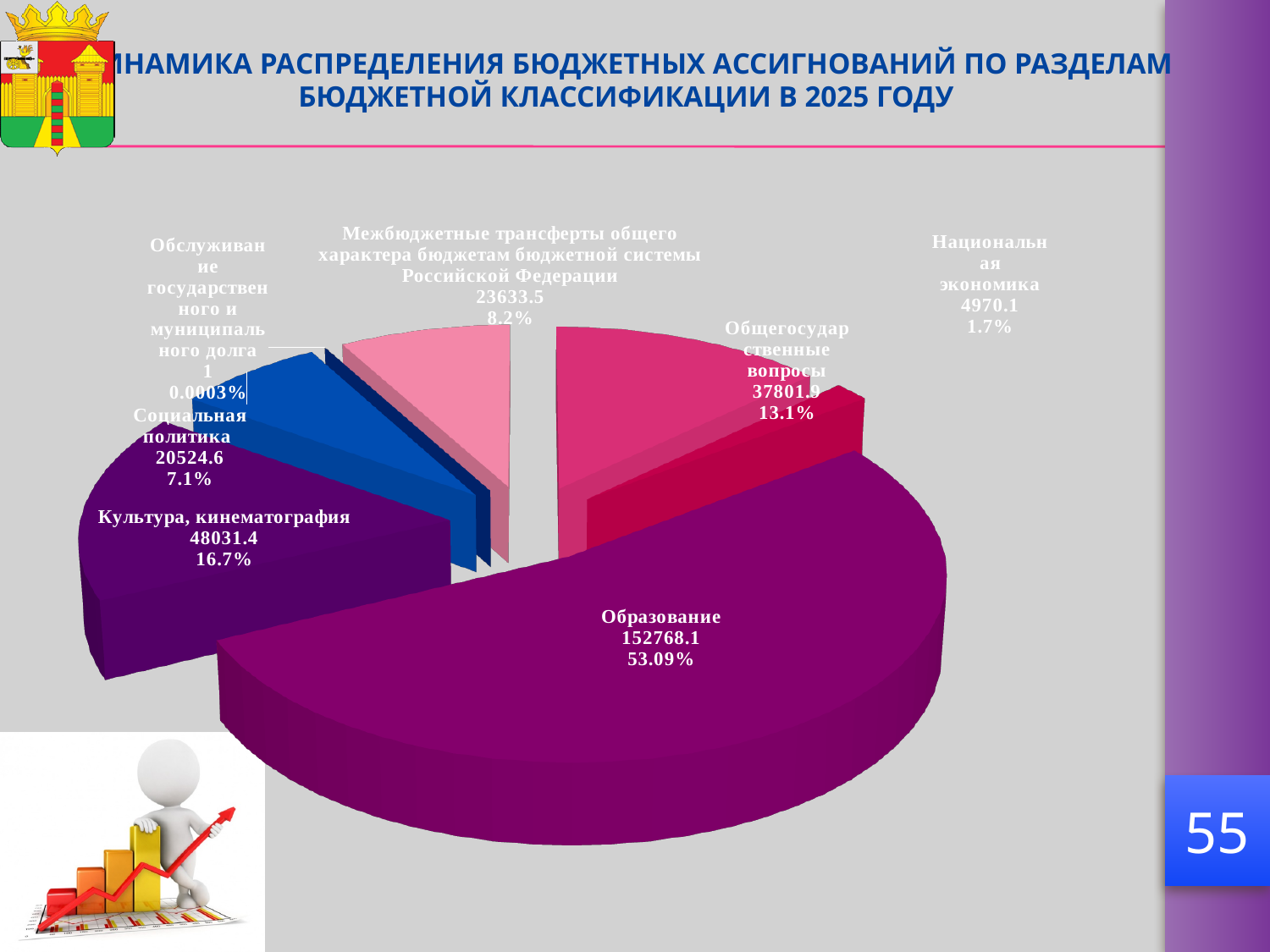
Which section has the largest slice of the pie? Образование What is the difference between the values for Культура, кинематография and Социальная политика? 27506.8 What kind of chart is shown on the slide? Pie chart How many sections are shown in the pie chart? 7 What share of the pie does Образование account for? 53.09% Which section has the smallest slice of the pie? Обслуживание государственного и муниципального долга What is the value shown for Культура, кинематография? 48031.4 What is the value shown for Образование? 152768.1 What share of the pie does Национальная экономика account for? 1.7% What is the value shown for Социальная политика? 20524.6 What share of the pie does Культура, кинематография account for? 16.7% Which is larger: Социальная политика or Межбюджетные трансферты общего характера бюджетам бюджетной системы Российской Федерации? Межбюджетные трансферты общего характера бюджетам бюджетной системы Российской Федерации